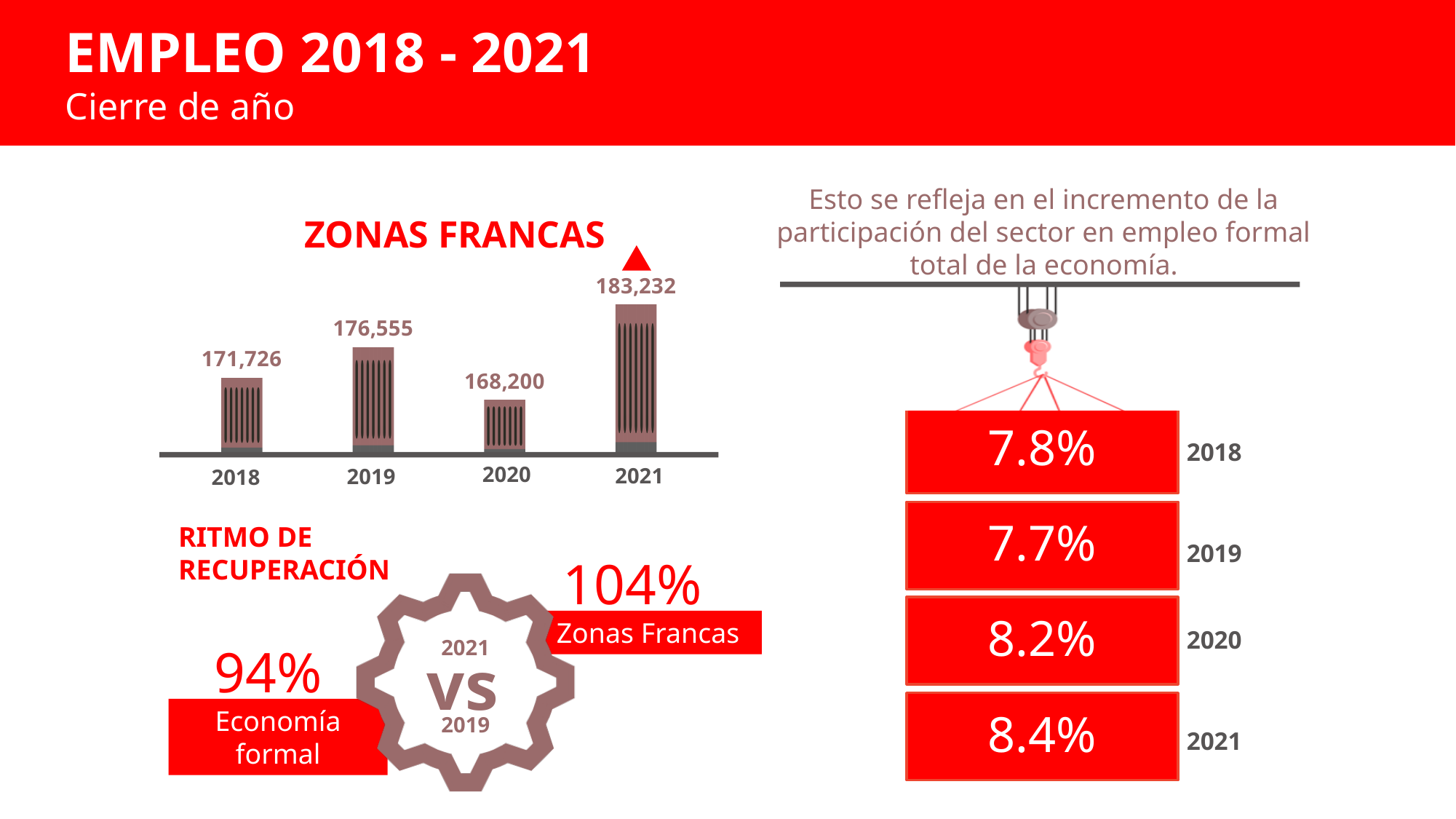
In the ZONAS FRANCAS chart, which is larger, the value for 2019 or the value for 2020? 2019 In the ZONAS FRANCAS chart, what is the difference between the 2021 and 2020 values? 15,032 What is the title of the bar chart on the left of the slide? ZONAS FRANCAS In the ZONAS FRANCAS chart, does the value rise or fall from 2020 to 2021? rise In the ZONAS FRANCAS chart, what is the value for 2018? 171,726 In the ZONAS FRANCAS chart, which year has the highest value? 2021 In the ZONAS FRANCAS chart, what is the difference between the 2019 and 2018 values? 4,829 How many years are shown in the ZONAS FRANCAS chart? 4 In the ZONAS FRANCAS chart, which year has the lowest value? 2020 What kind of chart is the ZONAS FRANCAS chart? bar chart In the ZONAS FRANCAS chart, what is the value for 2021? 183,232 In the ZONAS FRANCAS chart, what is the value for 2020? 168,200